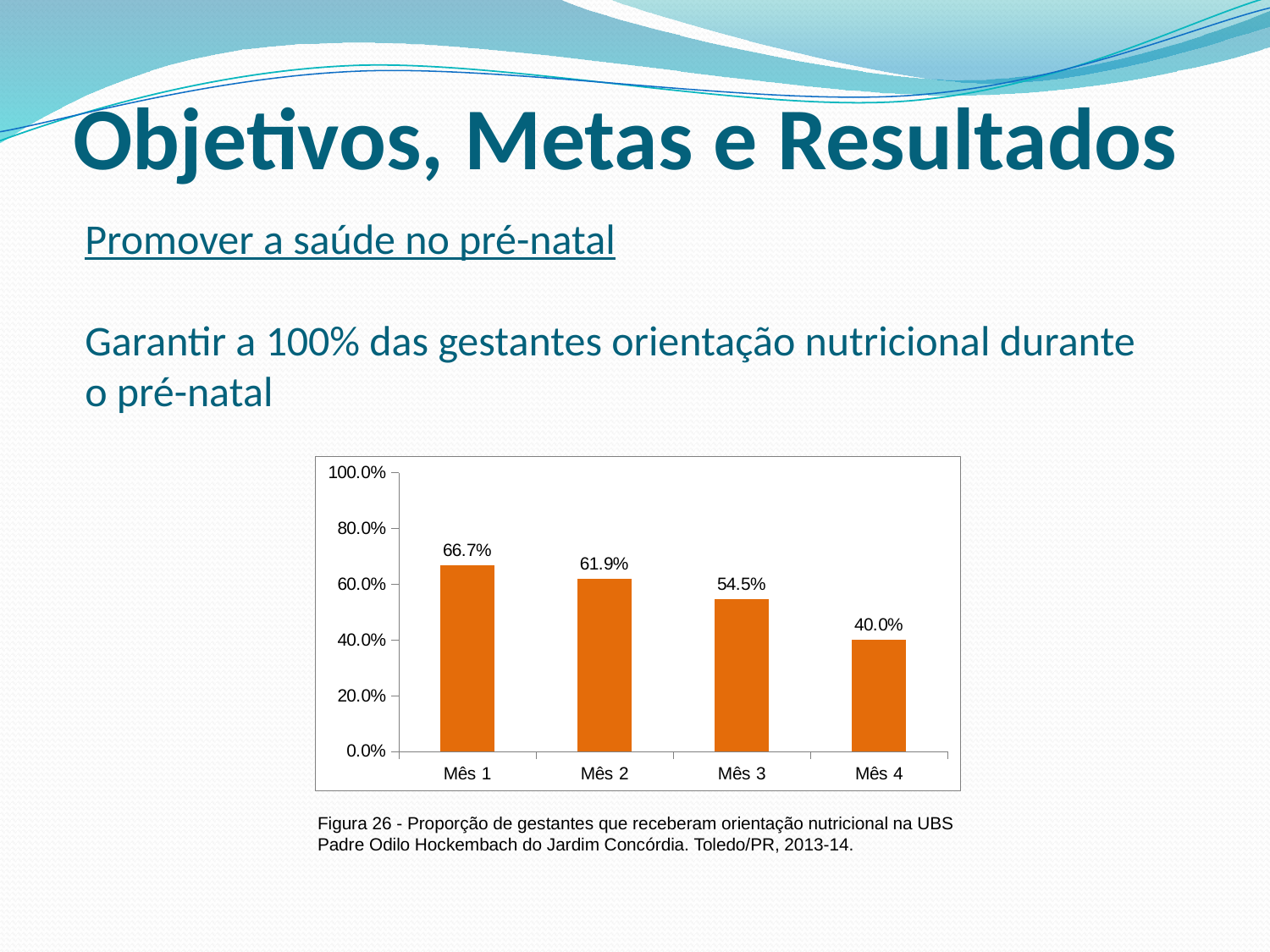
Which month has the lowest value? Mês 4 What is the value for Mês 1? 66.7% Do the values rise or fall from Mês 1 to Mês 4? fall What is the difference between the values for Mês 1 and Mês 4? 26.7% Which is larger, the value for Mês 2 or the value for Mês 3? Mês 2 What is the value for Mês 2? 61.9% Is the value for Mês 3 greater or less than 60.0%? less What kind of chart is shown on the slide? bar chart What is the value for Mês 4? 40.0% Which month has the highest value? Mês 1 How many months are shown on the x axis? 4 What is the value for Mês 3? 54.5%